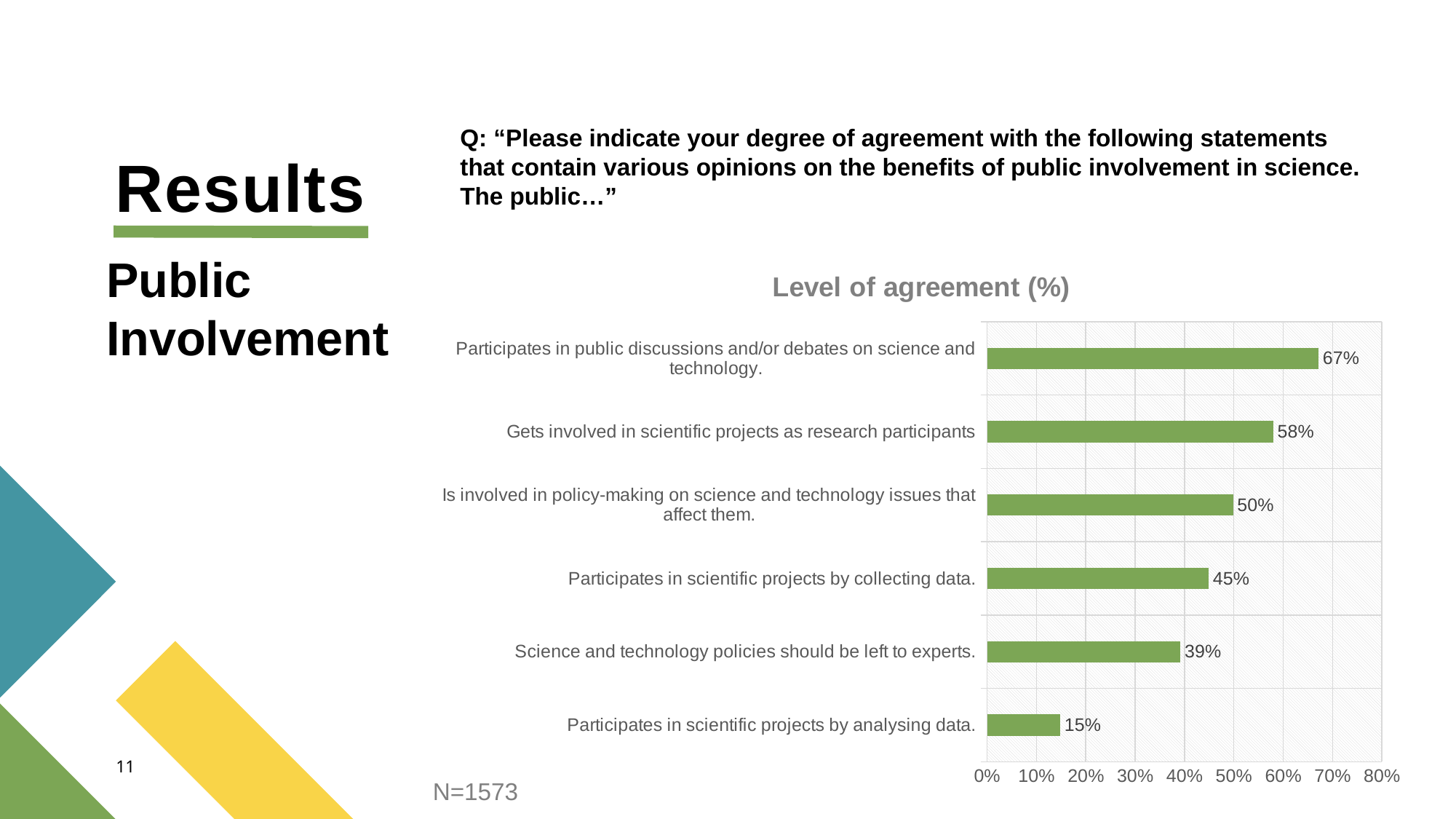
Is the value for "Gets involved in scientific projects as research participants" greater or less than 50%? greater What is the title of the chart? Level of agreement (%) What is the level of agreement for "Gets involved in scientific projects as research participants"? 58% Which has a higher level of agreement: "Is involved in policy-making on science and technology issues that affect them." or "Science and technology policies should be left to experts."? Is involved in policy-making on science and technology issues that affect them. What kind of chart is shown on the slide? Bar chart Which statement has the highest level of agreement? Participates in public discussions and/or debates on science and technology. Which statement has the lowest level of agreement? Participates in scientific projects by analysing data. What is the difference in level of agreement between "Participates in scientific projects by collecting data." and "Participates in scientific projects by analysing data."? 30% How many statements are shown in the chart? 6 What is the level of agreement for "Participates in public discussions and/or debates on science and technology."? 67% What is the level of agreement for "Science and technology policies should be left to experts."? 39% What is the sample size (N) shown on the slide? N=1573